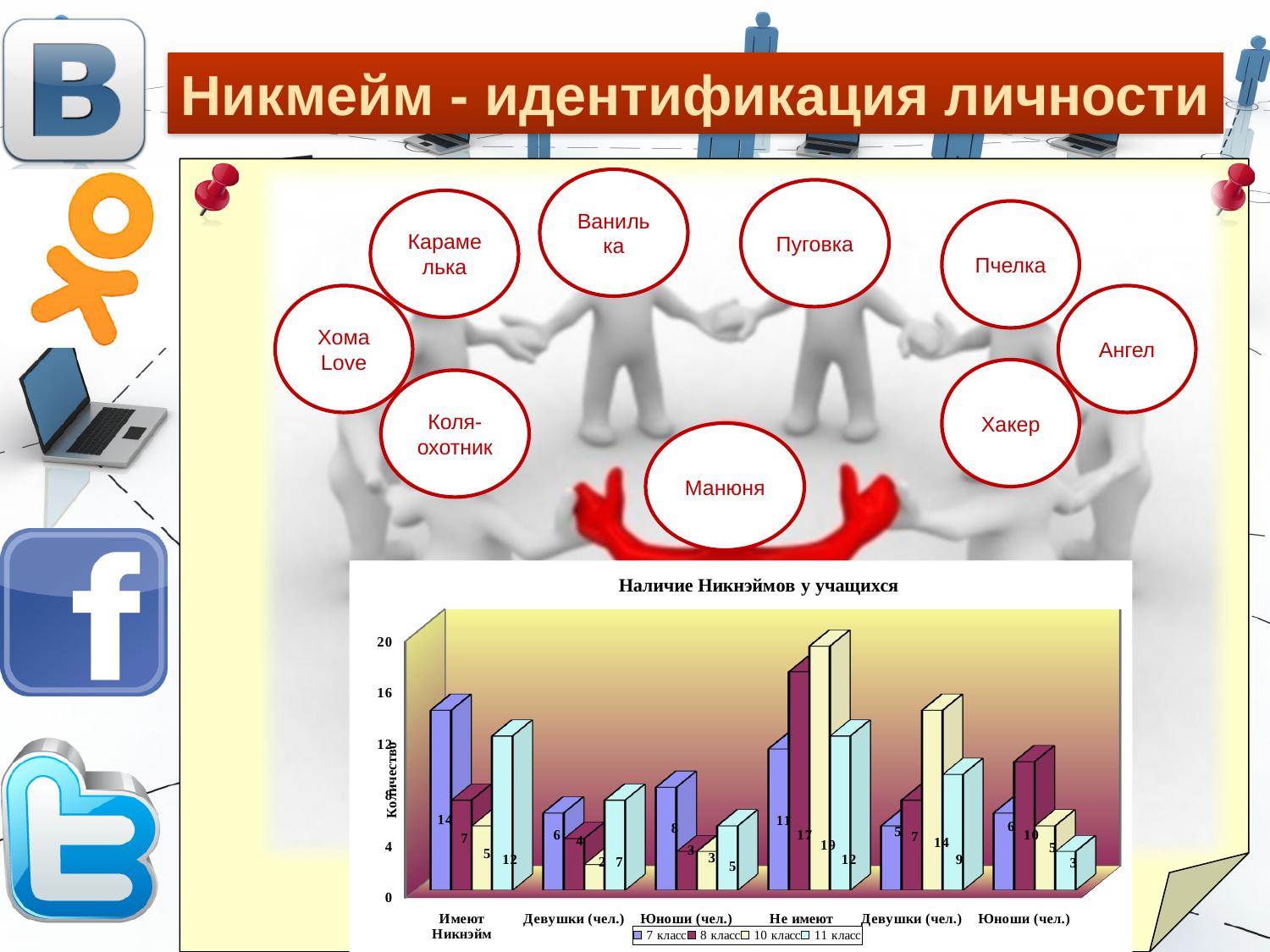
In the chart 'Наличие Никнэймов у учащихся', what is the value for 7 класс in the 'Имеют Никнэйм' category? 14 In the chart 'Наличие Никнэймов у учащихся', what is the value for 8 класс in the 'Не имеют' category? 17 How many series does the legend of the chart 'Наличие Никнэймов у учащихся' list? 4 In the chart 'Наличие Никнэймов у учащихся', what is the value for 10 класс in the 'Не имеют' category? 19 In the chart 'Наличие Никнэймов у учащихся', what is the difference between the 10 класс and 7 класс values in the 'Не имеют' category? 8 What kind of chart is 'Наличие Никнэймов у учащихся'? bar chart In the chart 'Наличие Никнэймов у учащихся', which series has the highest value in the 'Не имеют' category? 10 класс What is the title of the chart on the slide? Наличие Никнэймов у учащихся In the chart 'Наличие Никнэймов у учащихся', which is larger in the 'Имеют Никнэйм' category: 7 класс or 11 класс? 7 класс How many categories are shown on the x axis of the chart 'Наличие Никнэймов у учащихся'? 6 In the chart 'Наличие Никнэймов у учащихся', what is the difference between the 7 класс and 8 класс values in the 'Имеют Никнэйм' category? 7 In the chart 'Наличие Никнэймов у учащихся', which series has the lowest value in the 'Имеют Никнэйм' category? 10 класс